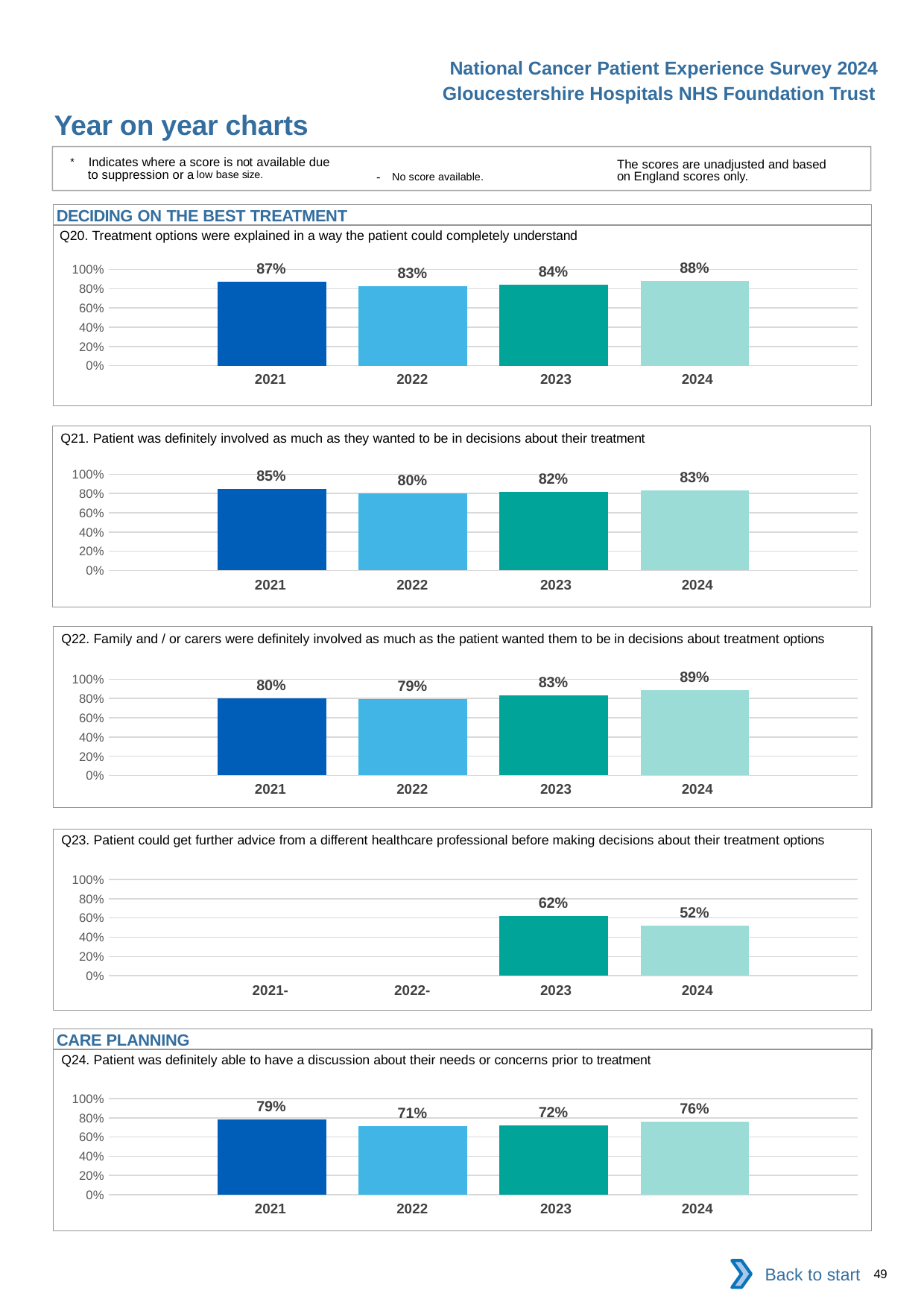
In the Q24 chart, what is the value for 2022? 71% In the Q23 chart, which is larger, the 2023 value or the 2024 value? 2023 In the Q22 chart, what is the value for 2023? 83% In the Q23 chart, how many years have a score shown? 2 In the Q22 chart, do the values rise or fall from 2022 to 2024? rise What kind of chart is the Q24 chart? bar chart In the Q21 chart, what is the difference between the 2021 and 2022 values? 5 percentage points In the Q24 chart, what is the difference between the 2021 and 2024 values? 3 percentage points In the Q20 chart, which year has the lowest value? 2022 In the Q23 chart, what is the value for 2024? 52% In the Q21 chart, which year has the highest value? 2021 In the Q20 chart, what is the value for 2024? 88%